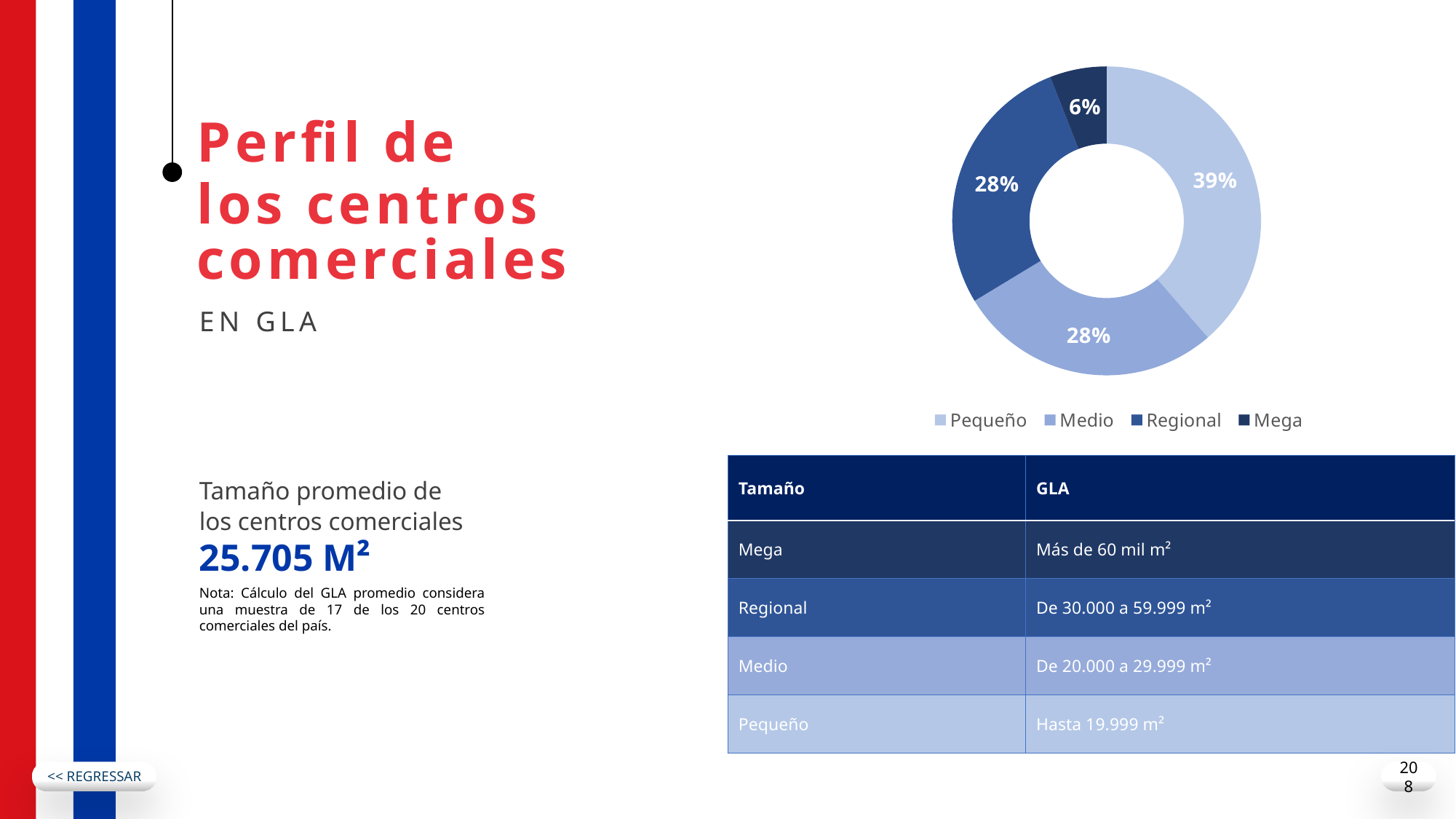
What percentage is shown for the Regional slice of the donut chart? 28% By how many percentage points does the Pequeño share exceed the Mega share in the donut chart? 33 percentage points What type of chart is shown on the slide? Donut (pie) chart Which category has the smallest share in the donut chart? Mega How many categories does the legend of the donut chart list? 4 What share of the donut chart is labelled for the Mega category? 6% What percentage is shown for the Medio slice of the donut chart? 28% What percentage of the donut chart does the Pequeño category represent? 39% Which category has the largest share in the donut chart? Pequeño Which has a larger share in the donut chart, Pequeño or Regional? Pequeño Which category is shown in the darkest navy colour in the donut chart? Mega How many slices does the donut chart have? 4